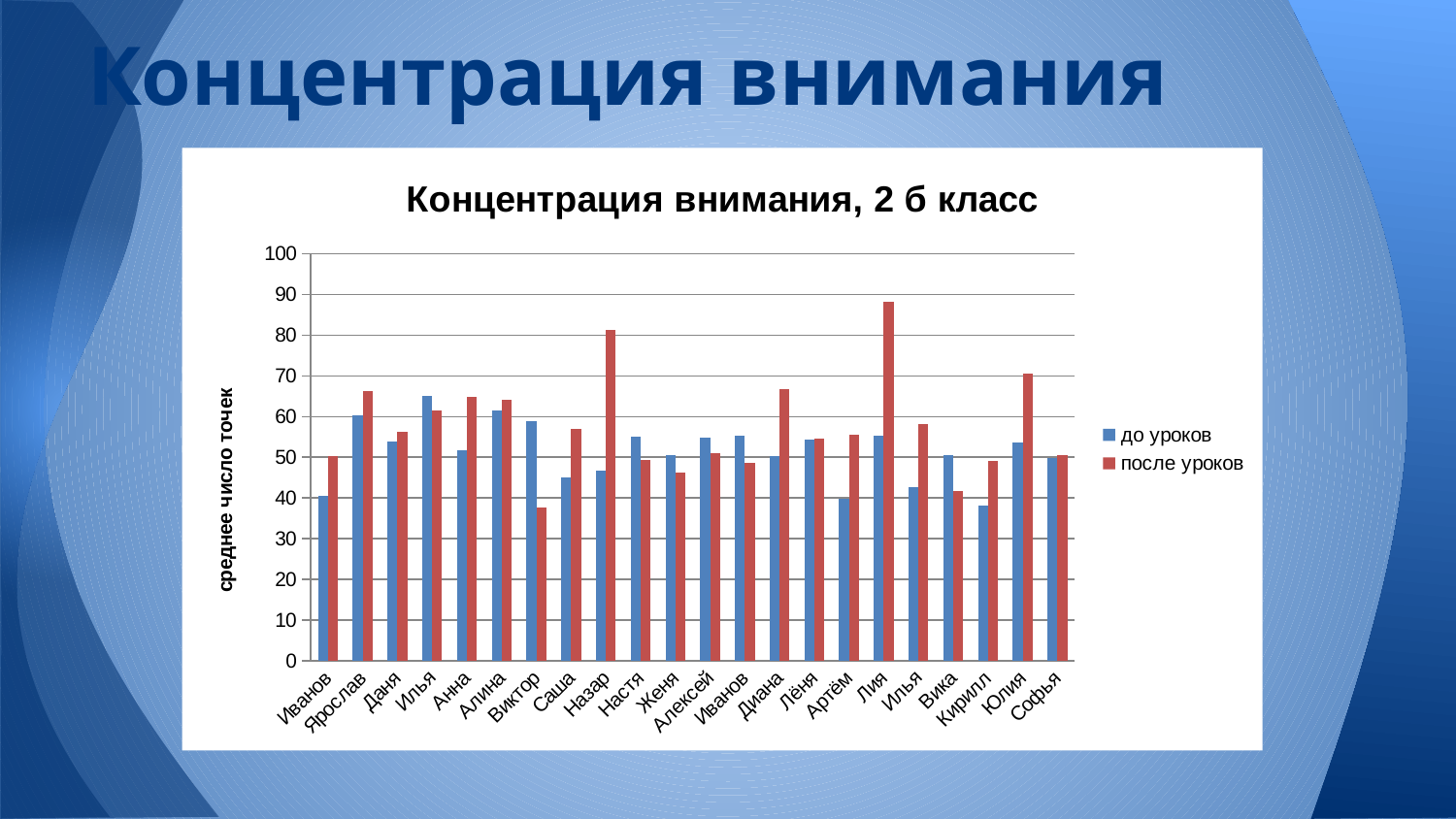
What kind of chart is shown on the slide? bar chart What is the title of the chart? Концентрация внимания, 2 б класс How many series does the legend list? 2 Which category has the highest value for the series 'после уроков'? Лия Which category has the lowest value for the series 'после уроков'? Виктор What are the two series named in the legend? до уроков, после уроков For Виктор, which is larger: the 'до уроков' value or the 'после уроков' value? до уроков For Диана, which is larger: the 'до уроков' value or the 'после уроков' value? после уроков Is the 'после уроков' value for Виктор greater or less than 40? less How many categories (names) are shown along the x axis? 22 Is the 'после уроков' value for Назар greater or less than 70? greater Is the 'после уроков' value for Лия greater or less than 80? greater